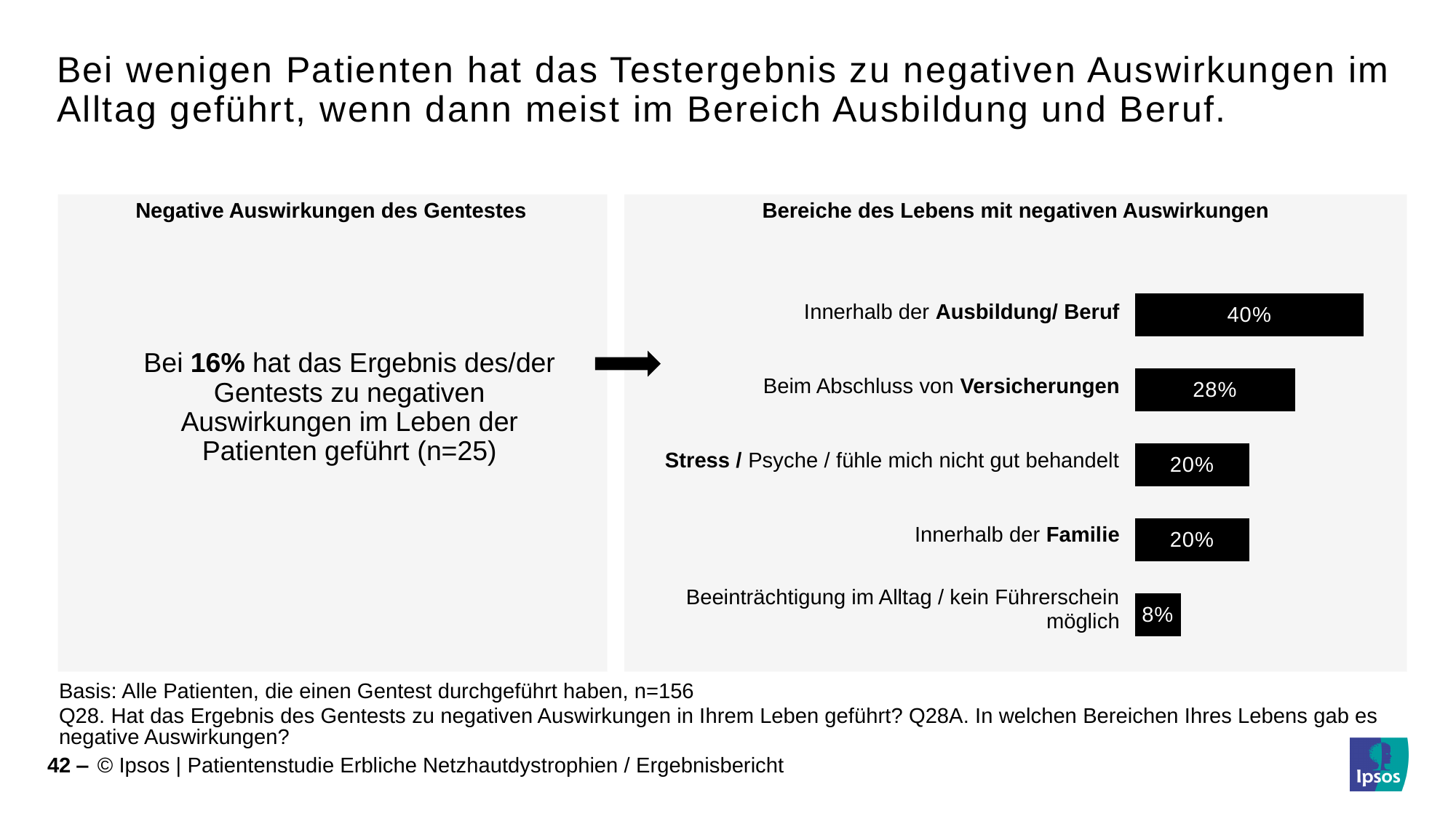
What is the value for 'Beeinträchtigung im Alltag / kein Führerschein möglich' in the chart 'Bereiche des Lebens mit negativen Auswirkungen'? 8% In the chart 'Bereiche des Lebens mit negativen Auswirkungen', what is the difference between 'Innerhalb der Ausbildung/ Beruf' and 'Beim Abschluss von Versicherungen'? 12% How many categories are shown in the chart 'Bereiche des Lebens mit negativen Auswirkungen'? 5 What is the value for 'Innerhalb der Ausbildung/ Beruf' in the chart 'Bereiche des Lebens mit negativen Auswirkungen'? 40% In the chart 'Bereiche des Lebens mit negativen Auswirkungen', which is larger: 'Beim Abschluss von Versicherungen' or 'Stress / Psyche / fühle mich nicht gut behandelt'? Beim Abschluss von Versicherungen What kind of chart is 'Bereiche des Lebens mit negativen Auswirkungen'? Bar chart What is the value for 'Innerhalb der Familie' in the chart 'Bereiche des Lebens mit negativen Auswirkungen'? 20% What is the value for 'Beim Abschluss von Versicherungen' in the chart 'Bereiche des Lebens mit negativen Auswirkungen'? 28% In the chart 'Bereiche des Lebens mit negativen Auswirkungen', what is the difference between 'Innerhalb der Familie' and 'Beeinträchtigung im Alltag / kein Führerschein möglich'? 12% According to the left panel 'Negative Auswirkungen des Gentestes', for what percentage of patients did the genetic test result lead to negative effects? 16% Which category has the lowest value in the chart 'Bereiche des Lebens mit negativen Auswirkungen'? Beeinträchtigung im Alltag / kein Führerschein möglich Which category has the highest value in the chart 'Bereiche des Lebens mit negativen Auswirkungen'? Innerhalb der Ausbildung/ Beruf